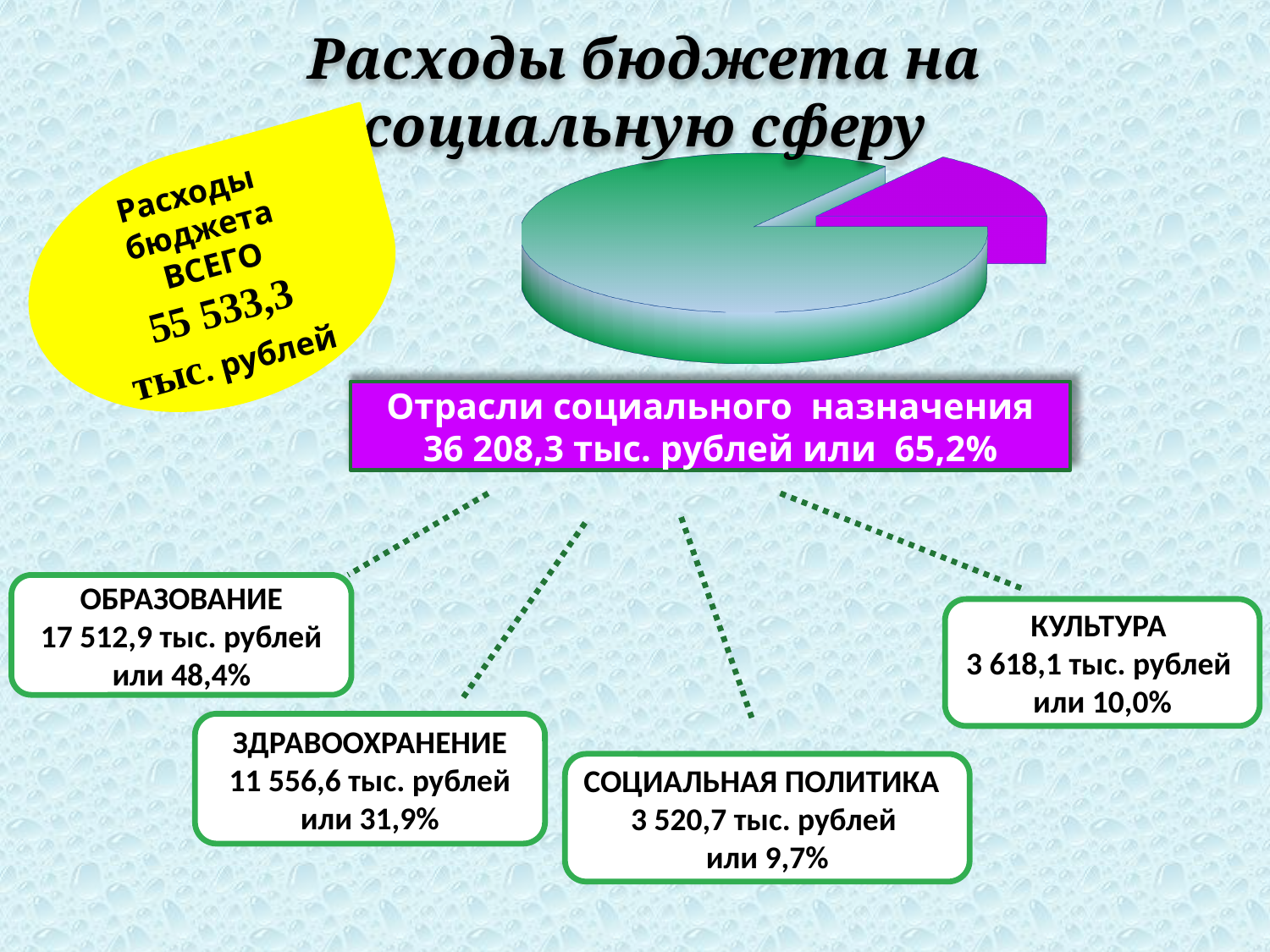
According to the slide, what share of the budget goes to social sectors (Отрасли социального назначения)? 65,2% According to the slide, which social sector has the smallest share: ОБРАЗОВАНИЕ, ЗДРАВООХРАНЕНИЕ, СОЦИАЛЬНАЯ ПОЛИТИКА or КУЛЬТУРА? СОЦИАЛЬНАЯ ПОЛИТИКА Which slice of the pie chart is pulled out (exploded) from the rest of the pie? the purple slice Is the purple slice of the pie chart greater or less than half of the pie? less According to the slide, what is the total budget expenditure (Расходы бюджета ВСЕГО)? 55 533,3 тыс. рублей Which slice of the pie chart is larger, the green one or the purple one? the green one Is the green slice of the pie chart greater or less than half of the pie? greater What is the title of the slide containing the pie chart? Расходы бюджета на социальную сферу According to the slide, what is the amount spent on education (ОБРАЗОВАНИЕ)? 17 512,9 тыс. рублей According to the slide, what percentage share does healthcare (ЗДРАВООХРАНЕНИЕ) have? 31,9% How many slices does the pie chart have? 2 What kind of chart is shown on the slide? pie chart